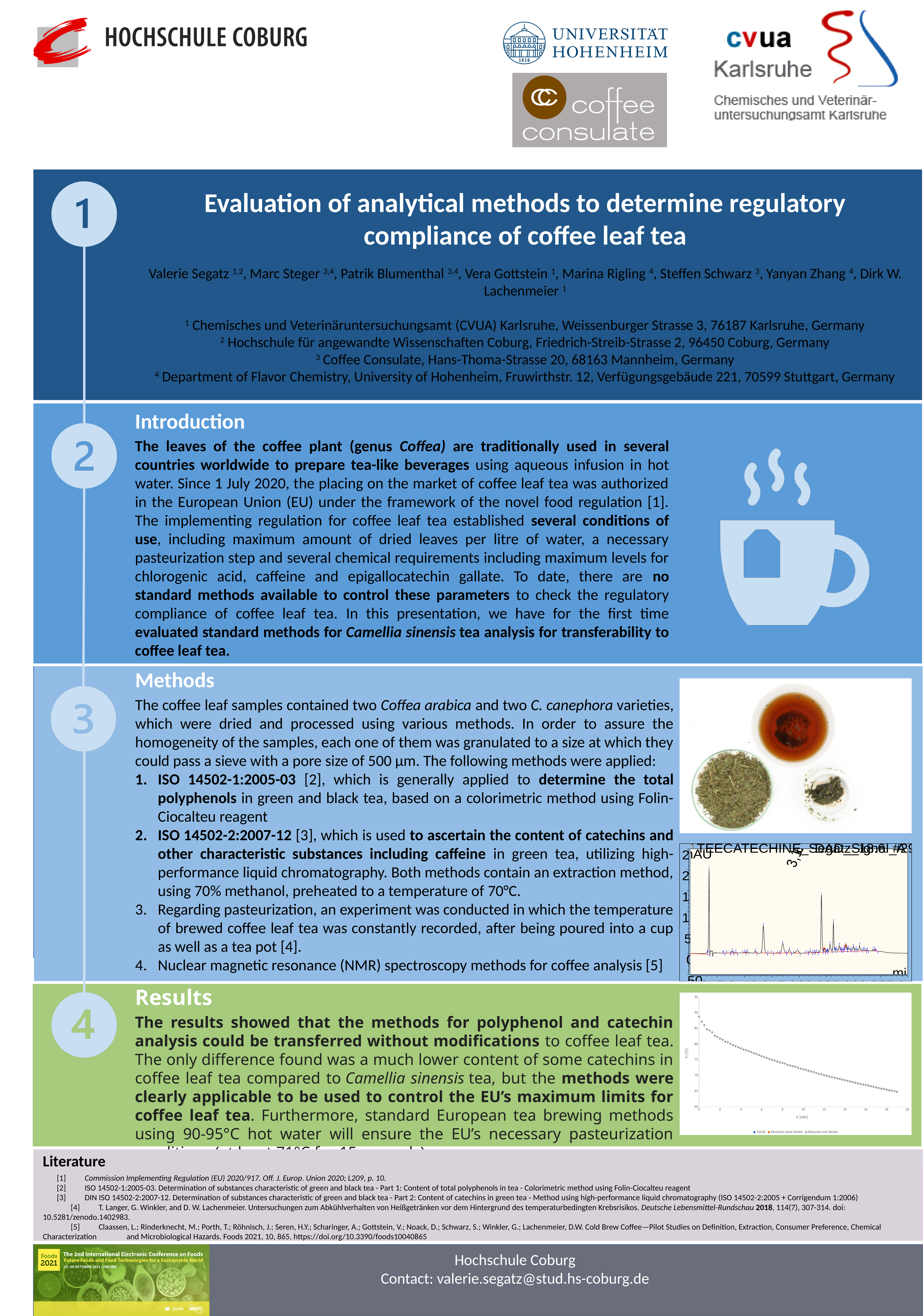
In the temperature chart in the Results section, is the temperature at 10 min greater or less than 80? less In the chromatogram in the Methods section, what unit is shown on the y axis? mAU In the temperature chart in the Results section, is the temperature at 0 min greater or less than 80? greater In the temperature chart in the Results section, do the values rise or fall as time increases along the x axis? fall In the temperature chart in the Results section, what quantity is plotted on the y axis? T / °C How many series does the legend of the temperature chart in the Results section list? 3 In the temperature chart in the Results section, what is the unit shown on the x axis? min What kind of chart is the chromatogram shown in the Methods section? line chart